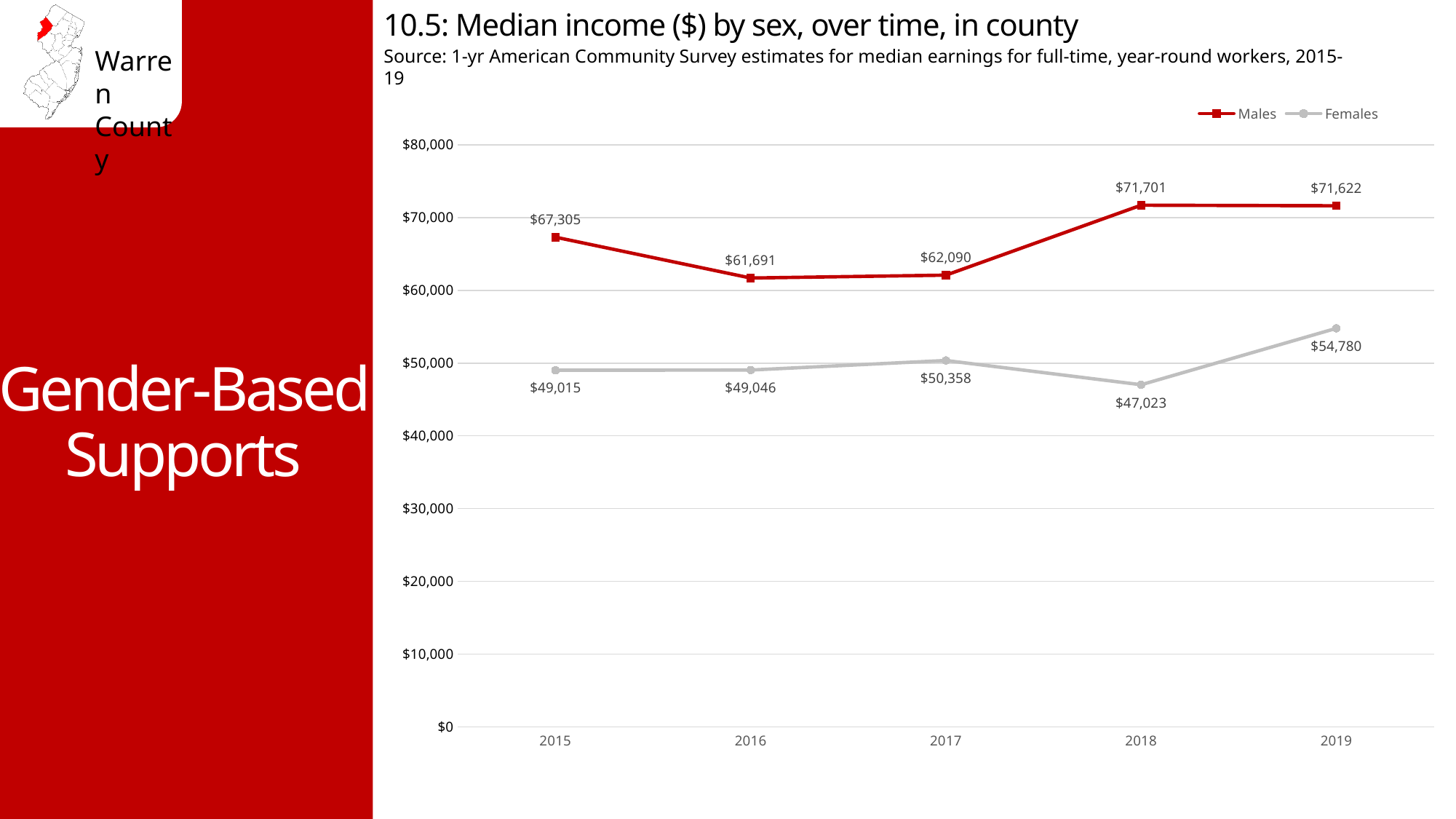
How many years are shown on the x axis? 5 How many series does the legend list? 2 What is the difference between the Males and Females median income in 2019? $16,842 What was the median income for Females in 2018? $47,023 Which was larger in 2017, the median income for Males or for Females? Males In which year was the median income for Females lowest? 2018 What kind of chart is shown on the slide? Line chart Did the median income for Females rise or fall from 2018 to 2019? Rise What was the median income for Males in 2015? $67,305 What was the median income for Females in 2019? $54,780 In which year was the median income for Males highest? 2018 Is the median income for Females in 2017 greater or less than $50,000? greater